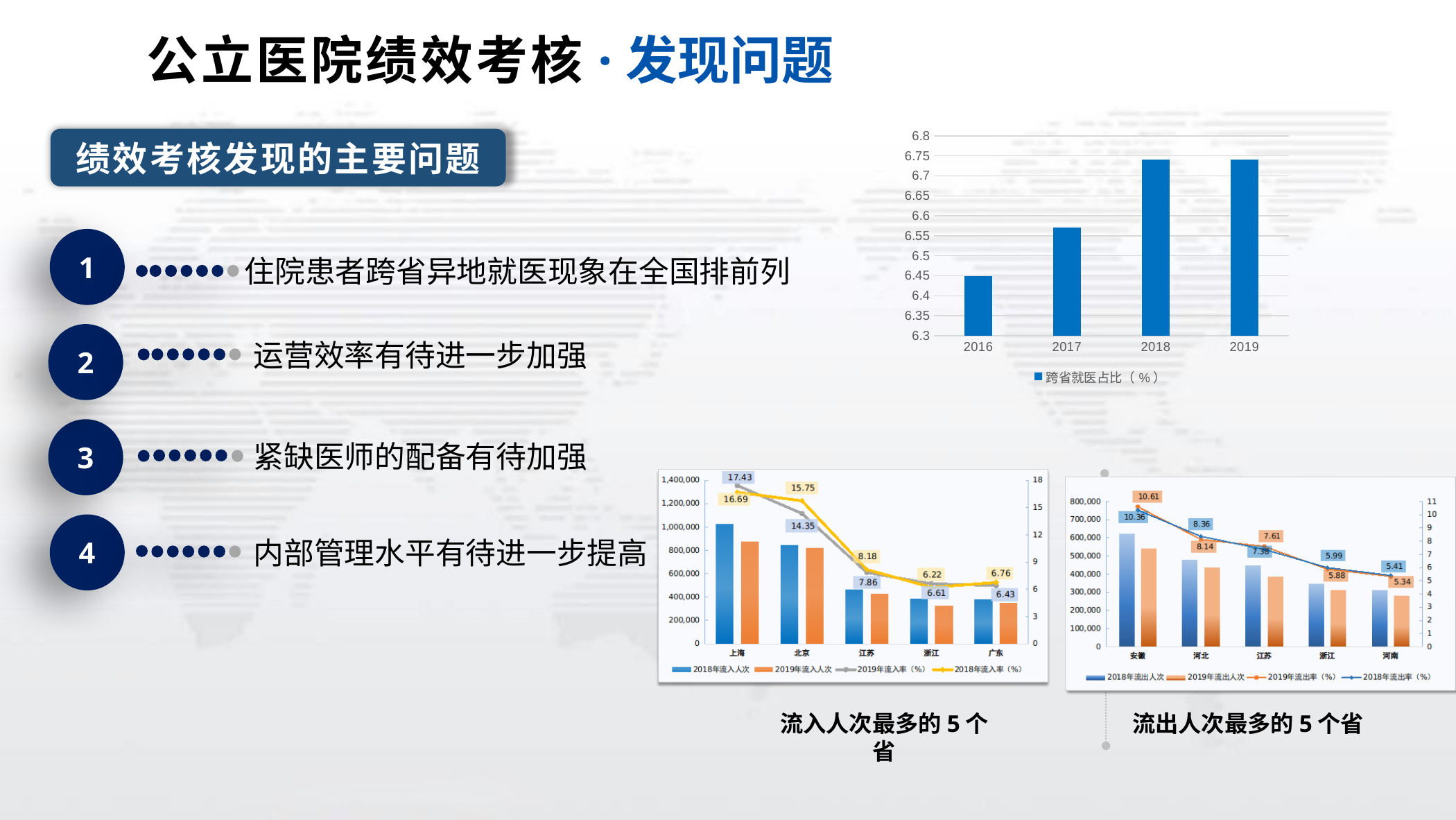
In the top-right 跨省就医占比（%） chart, is the value for 2018 greater or less than 6.7? greater In the bottom-middle chart (流入人次最多的5个省), which province has the tallest 2018年流入人次 bar? 上海 In the top-right 跨省就医占比（%） chart, is the value for 2016 greater or less than 6.5? less What type of chart is the top-right chart showing 跨省就医占比（%）? bar chart In the bottom-right chart (流出人次最多的5个省), which province has the tallest 2018年流出人次 bar? 安徽 How many series does the legend of the bottom-middle chart (流入人次最多的5个省) list? 4 How many years are shown on the x axis of the top-right 跨省就医占比（%） chart? 4 In the bottom-middle chart (流入人次最多的5个省), what is the highest rate value labeled on the lines? 17.43 How many provinces are shown on the x axis of the bottom-middle chart (流入人次最多的5个省)? 5 In the top-right 跨省就医占比（%） chart, which year has the lowest value? 2016 In the top-right 跨省就医占比（%） chart, do the values generally rise or fall from 2016 to 2019? rise